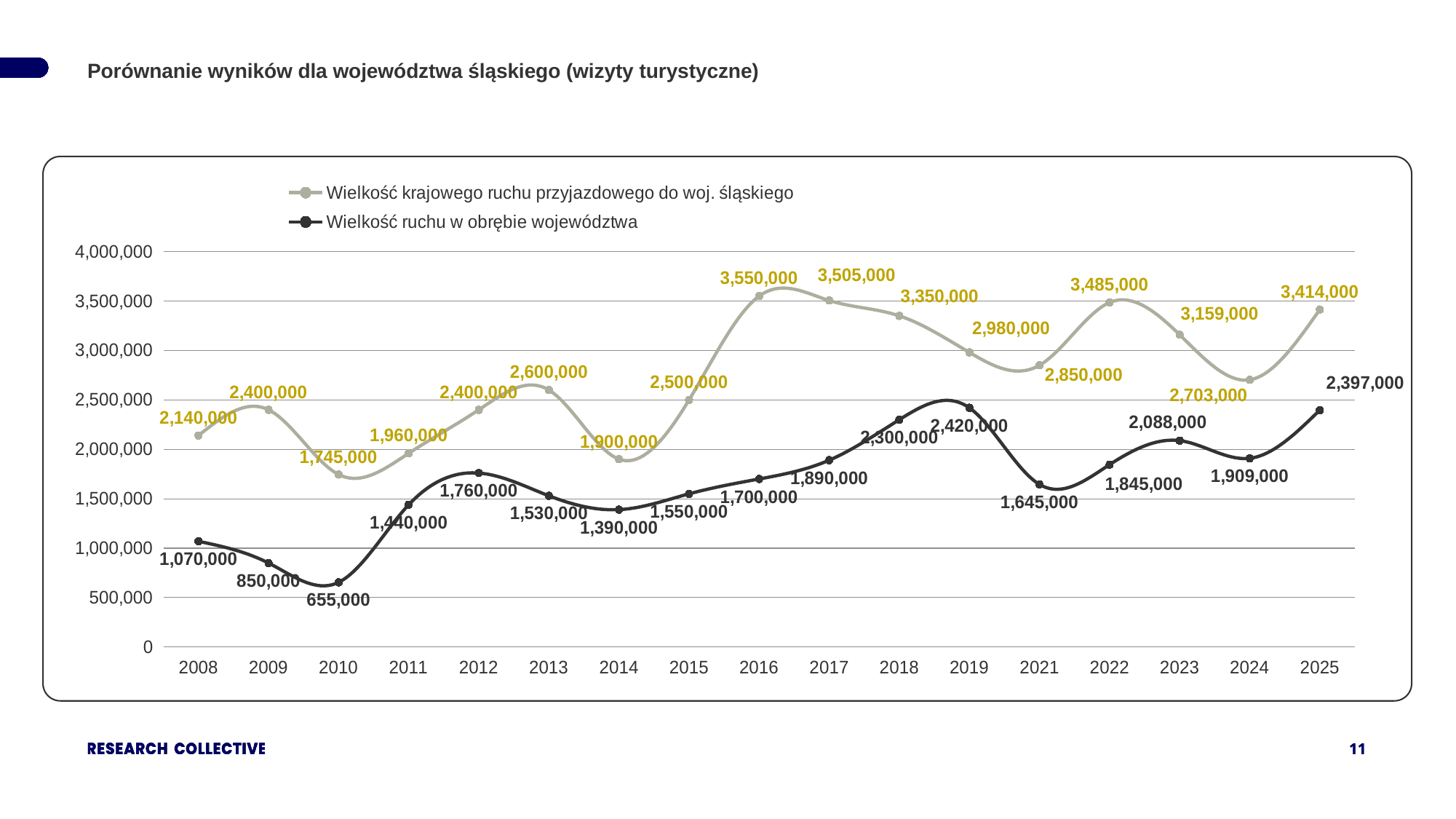
Which series has the larger value in 2019? Wielkość krajowego ruchu przyjazdowego do woj. śląskiego What is the title of the chart on the slide? Porównanie wyników dla województwa śląskiego (wizyty turystyczne) In which year is 'Wielkość ruchu w obrębie województwa' highest? 2019 What is the value of 'Wielkość krajowego ruchu przyjazdowego do woj. śląskiego' in 2016? 3,550,000 What is the difference between the two series in 2025? 1,017,000 In which year is 'Wielkość ruchu w obrębie województwa' lowest? 2010 How many years are shown on the x axis? 17 What type of chart is shown on the slide? Line chart What is the value of 'Wielkość ruchu w obrębie województwa' in 2025? 2,397,000 How many series does the legend list? 2 In which year is 'Wielkość krajowego ruchu przyjazdowego do woj. śląskiego' highest? 2016 What is the value of 'Wielkość ruchu w obrębie województwa' in 2010? 655,000